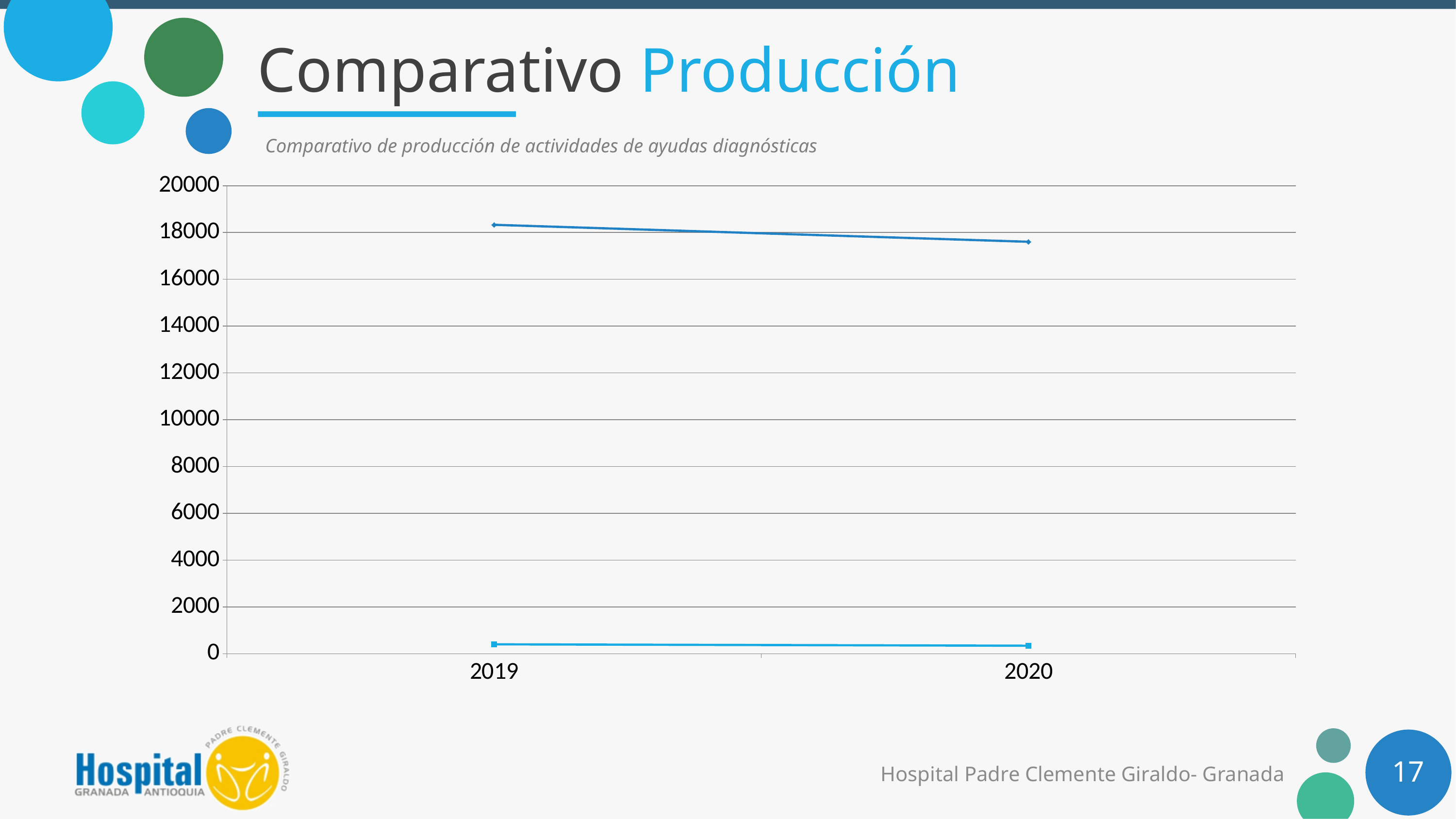
Is the value of the upper (dark blue) line in 2020 greater or less than 20000? less For the upper (dark blue) line, which year has the larger value, 2019 or 2020? 2019 Is the value of the lower (light blue) line in 2020 greater or less than 4000? less In 2019, which line has the larger value, the upper dark blue line or the lower light blue line? the upper dark blue line What kind of chart is shown on the slide? line chart What is the subtitle text shown above the chart? Comparativo de producción de actividades de ayudas diagnósticas How many years are shown on the x axis of the chart? 2 What is the highest value shown on the y axis of the chart? 20000 Does the upper (dark blue) line rise or fall from 2019 to 2020? fall Is the value of the lower (light blue) line in 2019 greater or less than 2000? less How many lines are plotted on the chart? 2